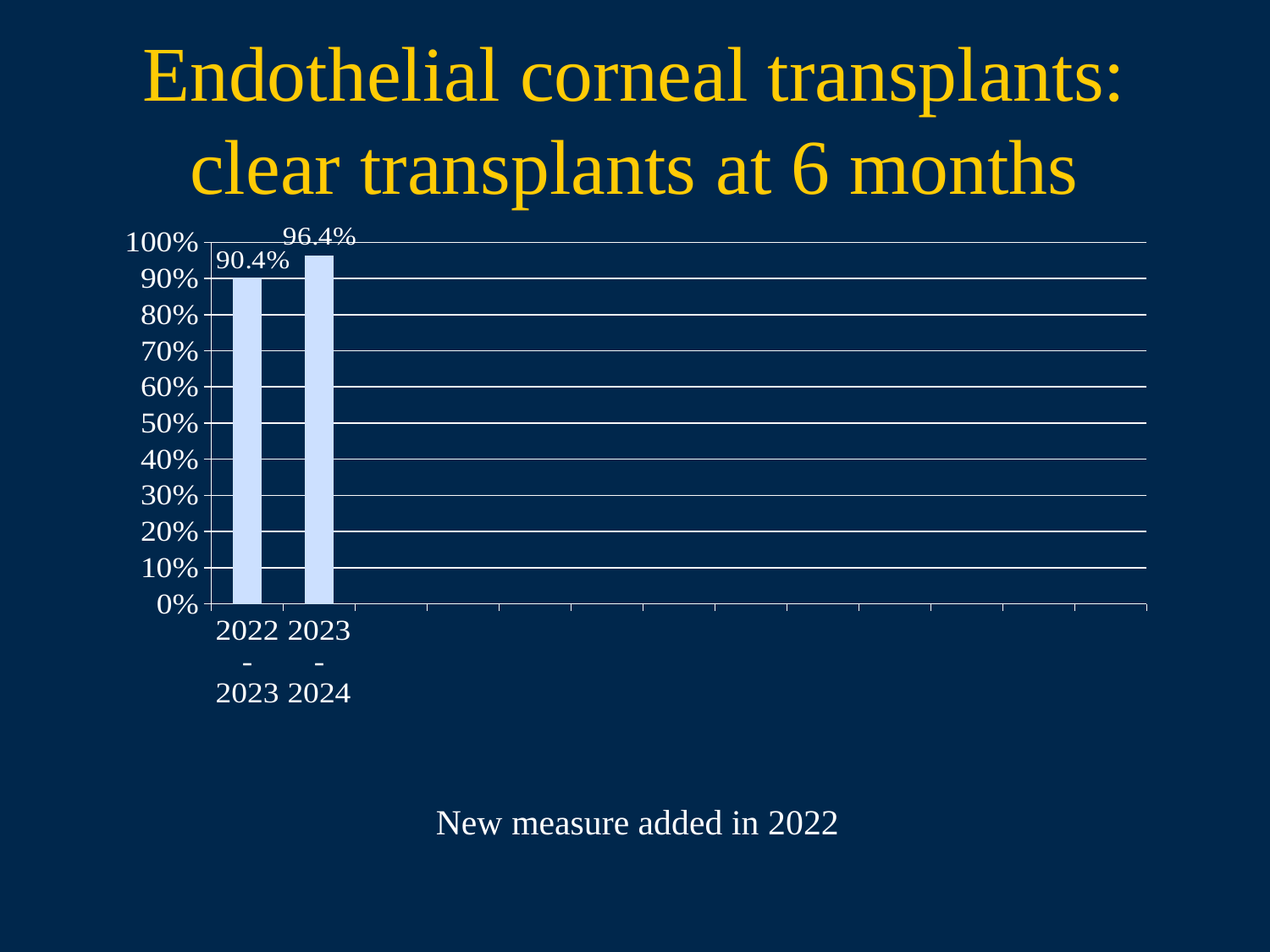
Which is larger, the value for 2022-2023 or the value for 2023-2024? 2023-2024 What is the value for 2022-2023? 90.4% How many bars are plotted on the chart? 2 Is the value for 2022-2023 greater or less than 80%? greater Do the values rise or fall from 2022-2023 to 2023-2024? Rise What is the title of the slide? Endothelial corneal transplants: clear transplants at 6 months Which period has the highest value? 2023-2024 What is the value for 2023-2024? 96.4% Which period has the lowest value? 2022-2023 Is the value for 2023-2024 greater or less than 100%? less What kind of chart is shown on the slide? Bar chart What is the difference between the values for 2023-2024 and 2022-2023? 6 percentage points